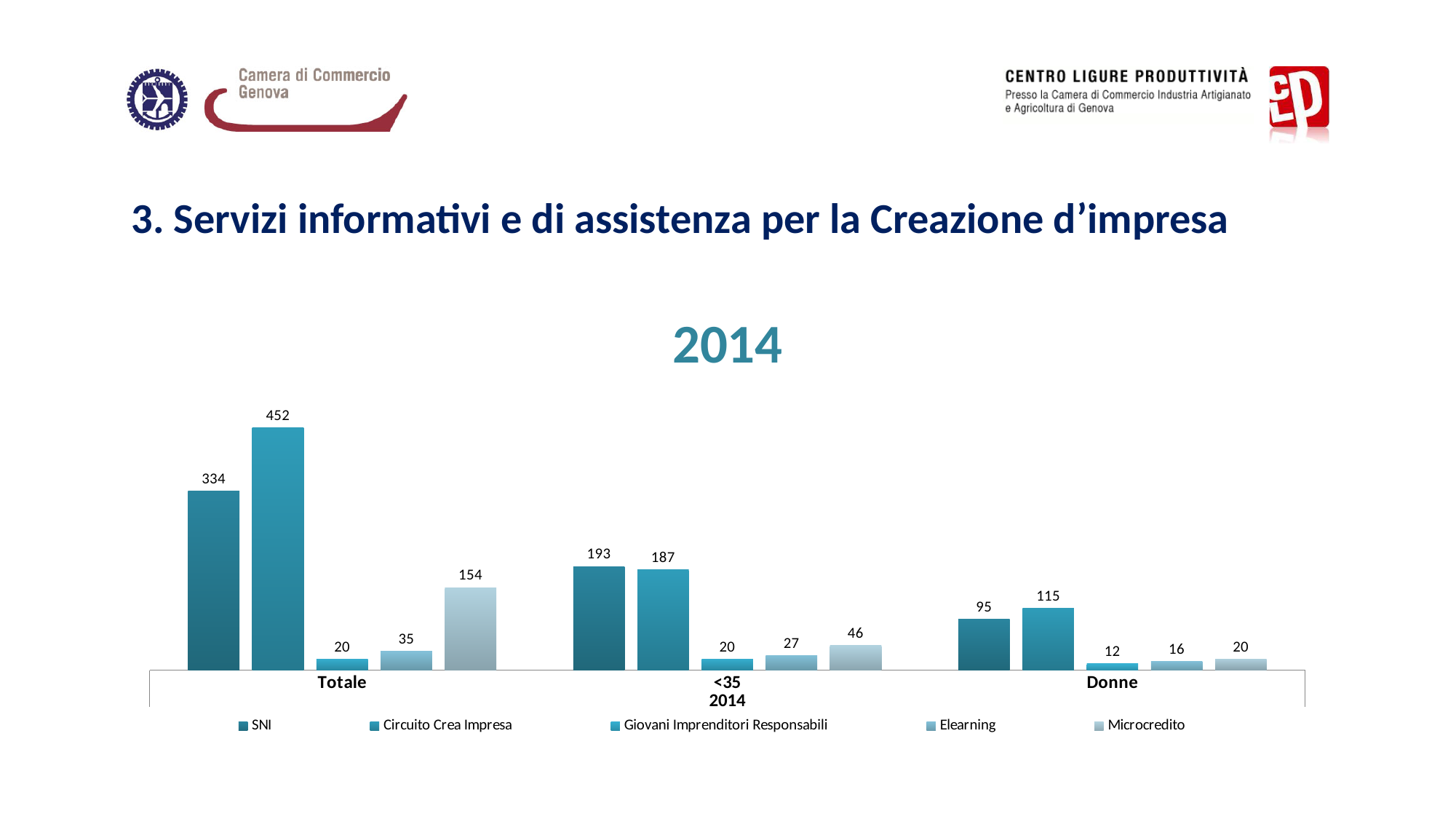
How many category groups are shown on the x axis? 3 What is the value for SNI in the <35 group? 193 Which series has the highest value in the Totale group? Circuito Crea Impresa What is the difference between Circuito Crea Impresa and SNI in the Totale group? 118 How many series does the legend list? 5 What is the value for Circuito Crea Impresa in the Totale group? 452 What is the title of the chart? 2014 What kind of chart is shown on the slide? Bar chart What is the value for Elearning in the <35 group? 27 Which is larger in the Donne group, SNI or Circuito Crea Impresa? Circuito Crea Impresa What is the value for Microcredito in the Donne group? 20 Which series has the lowest value in the Donne group? Giovani Imprenditori Responsabili